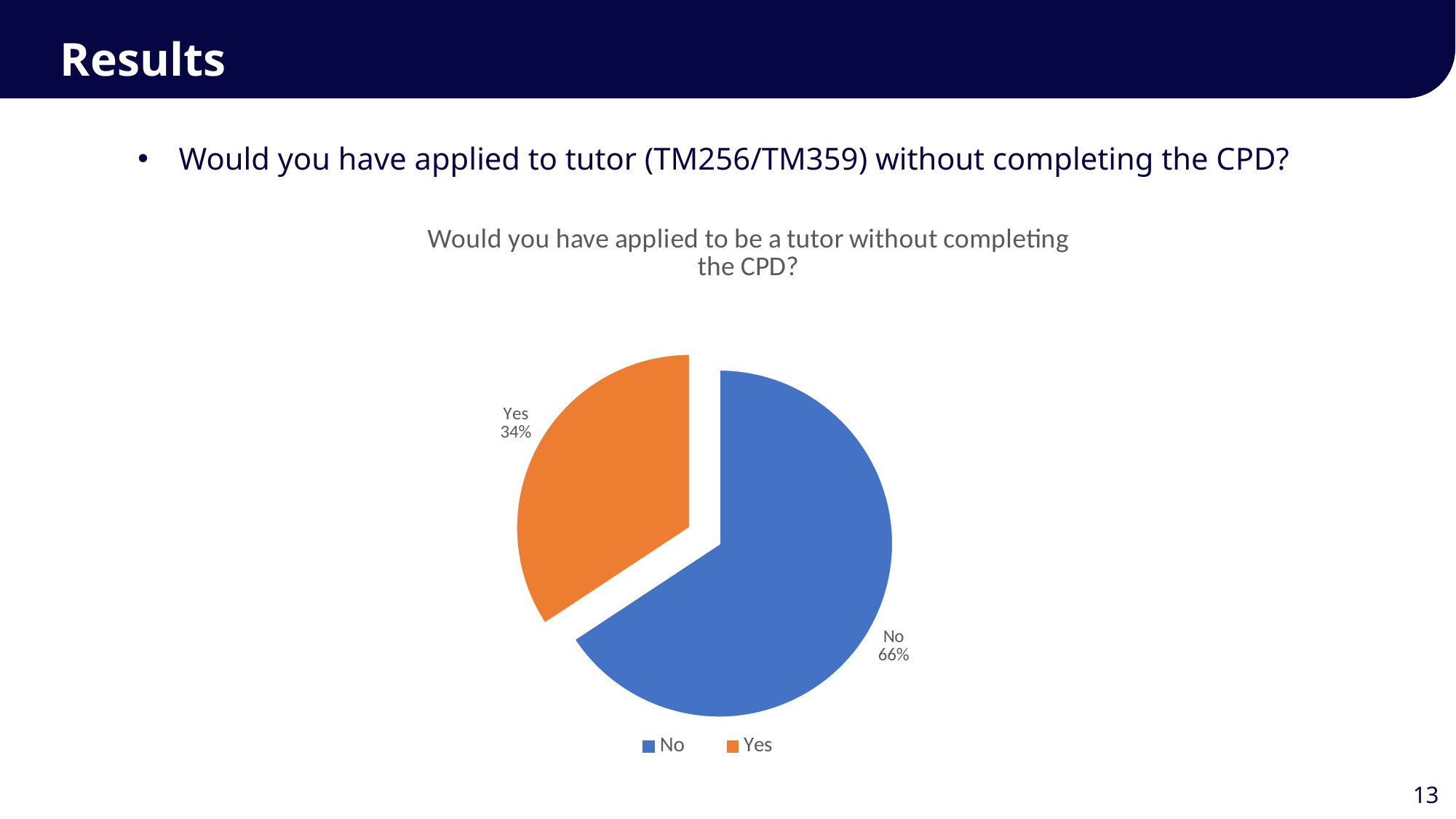
How many slices does the pie chart have? 2 Which is larger, the "Yes" slice or the "No" slice? No Which slice is the smallest in the pie chart? Yes Which slice is the largest in the pie chart? No How many entries does the legend list? 2 What share of the pie does the "Yes" slice represent? 34% What is the difference in percentage points between the "No" and "Yes" slices? 32 What is the title of the chart? Would you have applied to be a tutor without completing the CPD? What colour is the "Yes" slice in the pie chart? Orange What kind of chart is shown on the slide? Pie chart What share of the pie does the "No" slice represent? 66%